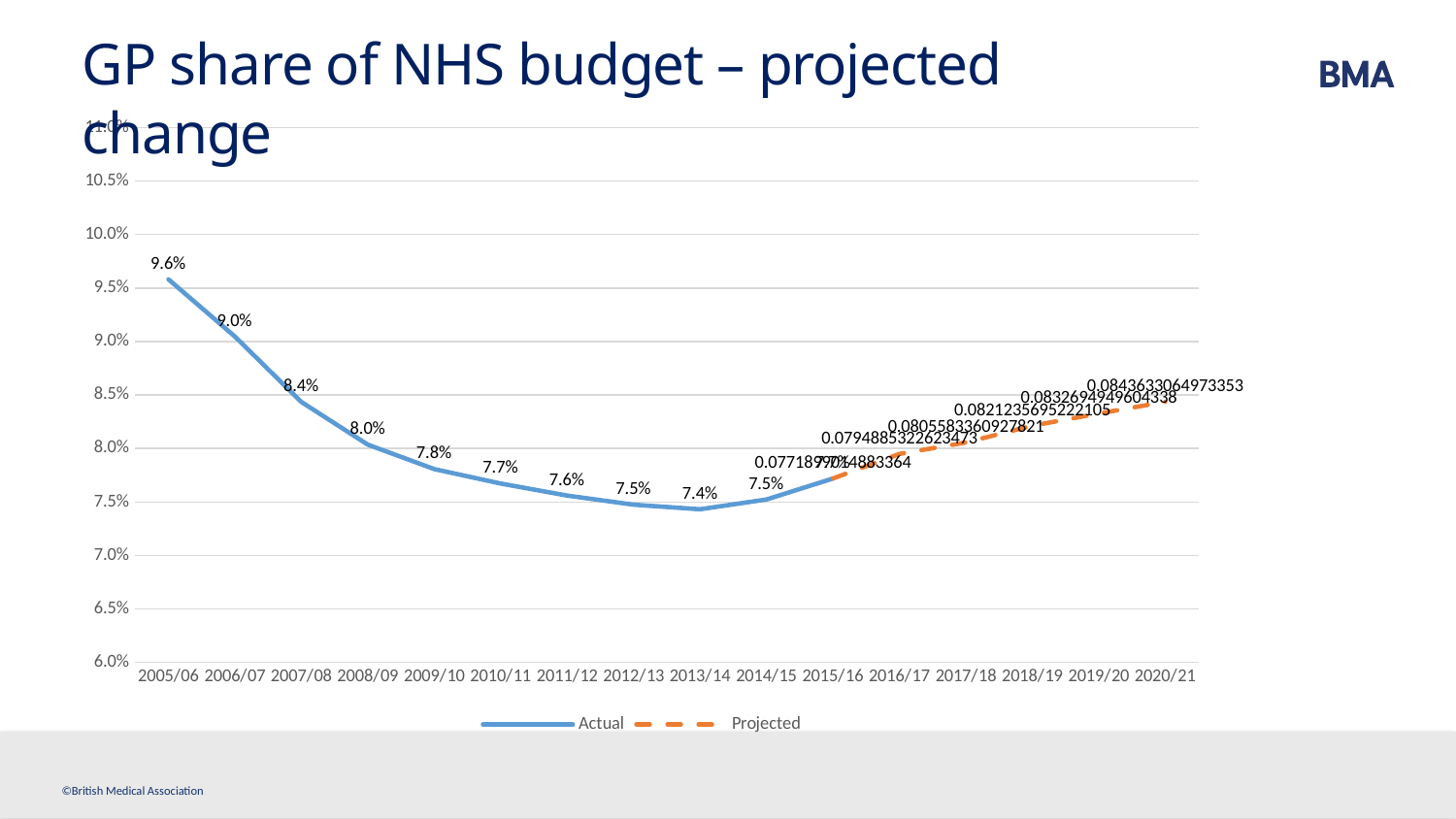
What is the GP share of NHS budget for 2013/14? 7.4% Which year has the highest GP share of NHS budget? 2005/06 Which is larger, the value for 2009/10 or the value for 2011/12? 2009/10 What is the GP share of NHS budget for 2005/06? 9.6% How many years are shown on the x axis? 16 What are the two series named in the legend? Actual and Projected What is the projected value labelled for 2020/21? 0.0843633064973353 What is the difference between the values for 2005/06 and 2006/07? 0.6 percentage points What kind of chart is shown on the slide? Line chart Do the values rise or fall from 2005/06 to 2013/14? Fall How many series does the legend list? 2 Which year has the lowest GP share of NHS budget? 2013/14